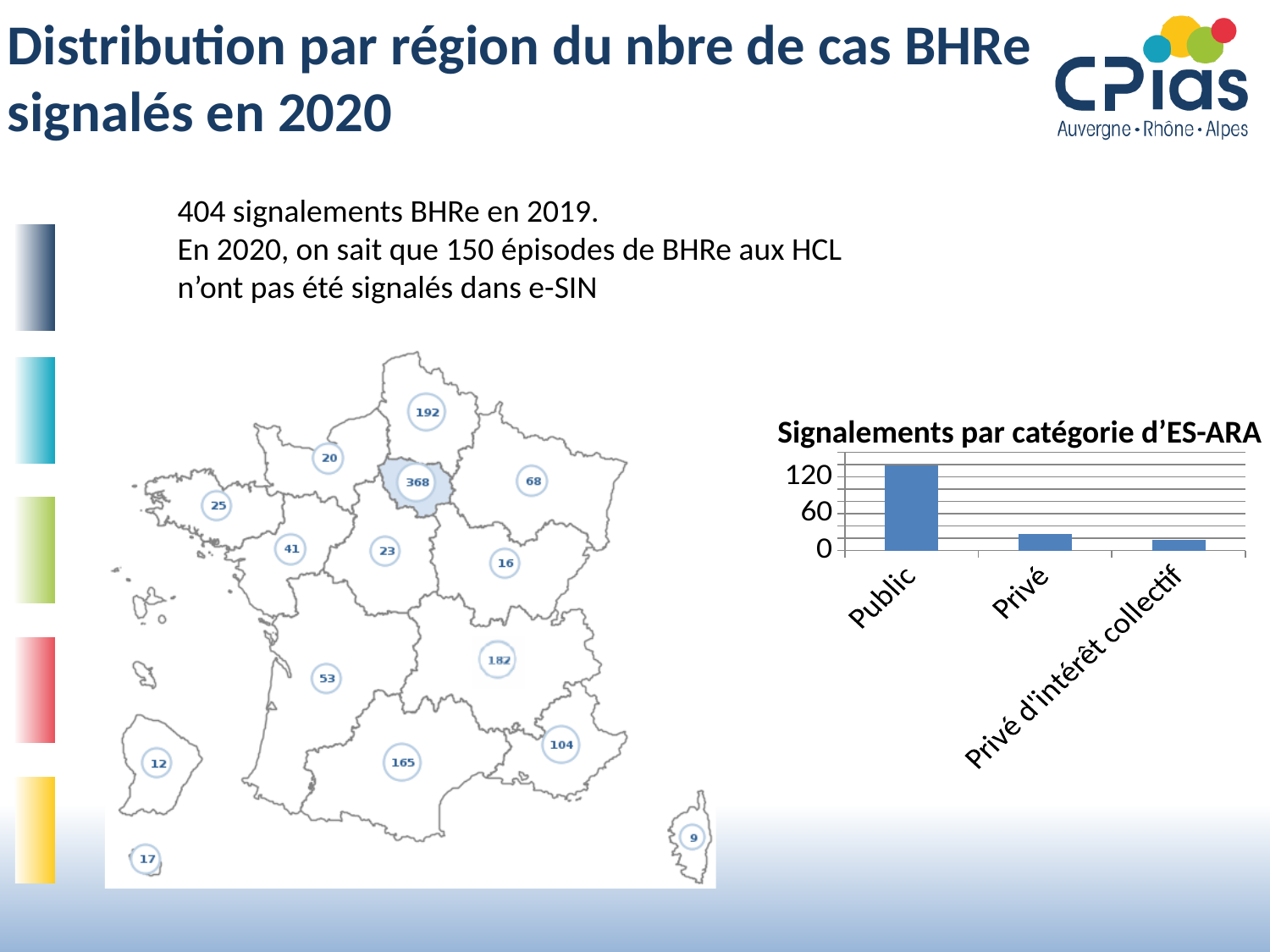
In the 'Signalements par catégorie d'ES-ARA' chart, is the value for Privé d'intérêt collectif greater or less than 60? less What is the title of the bar chart on the right of the slide? Signalements par catégorie d'ES-ARA How many categories are shown in the 'Signalements par catégorie d'ES-ARA' chart? 3 In the 'Signalements par catégorie d'ES-ARA' chart, which category has the lowest value? Privé d'intérêt collectif In the 'Signalements par catégorie d'ES-ARA' chart, which is larger, Public or Privé? Public In the 'Signalements par catégorie d'ES-ARA' chart, do the values rise or fall from left to right along the x axis? fall On the map on the left of the slide, what is the highest number of cases shown for a region? 368 In the 'Signalements par catégorie d'ES-ARA' chart, which category has the highest value? Public On the map on the left of the slide, what is the lowest number of cases shown for a region? 9 In the 'Signalements par catégorie d'ES-ARA' chart, is the value for Privé greater or less than 60? less In the 'Signalements par catégorie d'ES-ARA' chart, is the value for Public greater or less than 120? greater What kind of chart is 'Signalements par catégorie d'ES-ARA'? bar chart